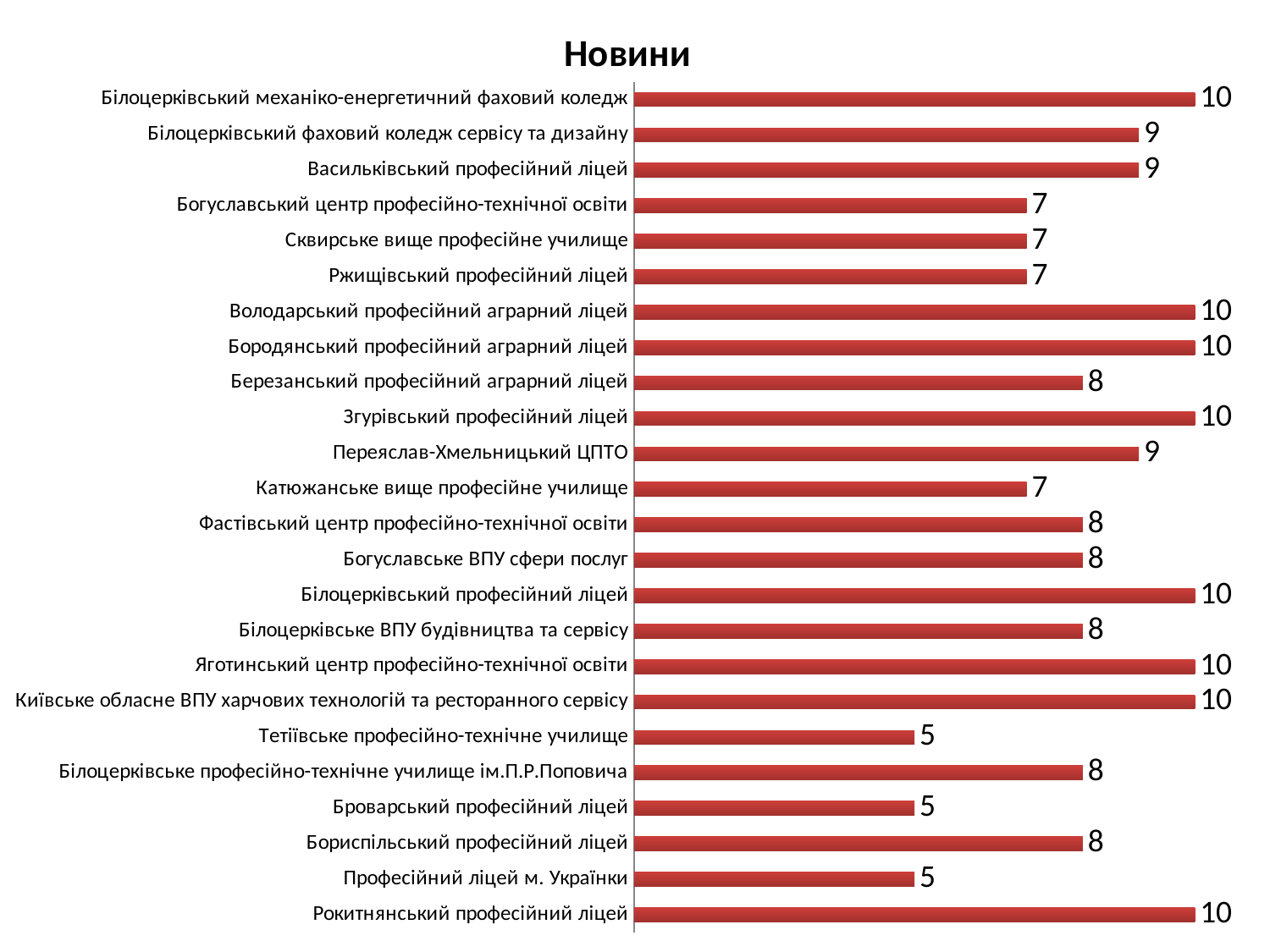
What is the highest value shown on the chart? 10 What is the value for Рокитнянський професійний ліцей? 10 What is the value for Скв ирське вище професійне училище? 7 What is the lowest value shown on the chart? 5 How many categories are shown on the chart? 24 What is the value for Березанський професійний аграрний ліцей? 8 Which is larger, the value for Професійний ліцей м. Українки or the value for Бориспільський професійний ліцей? Бориспільський професійний ліцей What is the difference between the values for Білоцерківський механіко-енергетичний фаховий коледж and Броварський професійний ліцей? 5 What is the value for Переяслав-Хмельницький ЦПТО? 9 Which is larger, the value for Васильківський професійний ліцей or the value for Богуславський центр професійно-технічної освіти? Васильківський професійний ліцей What kind of chart is shown on the slide? Bar chart What is the value for Тетіївське професійно-технічне училище? 5